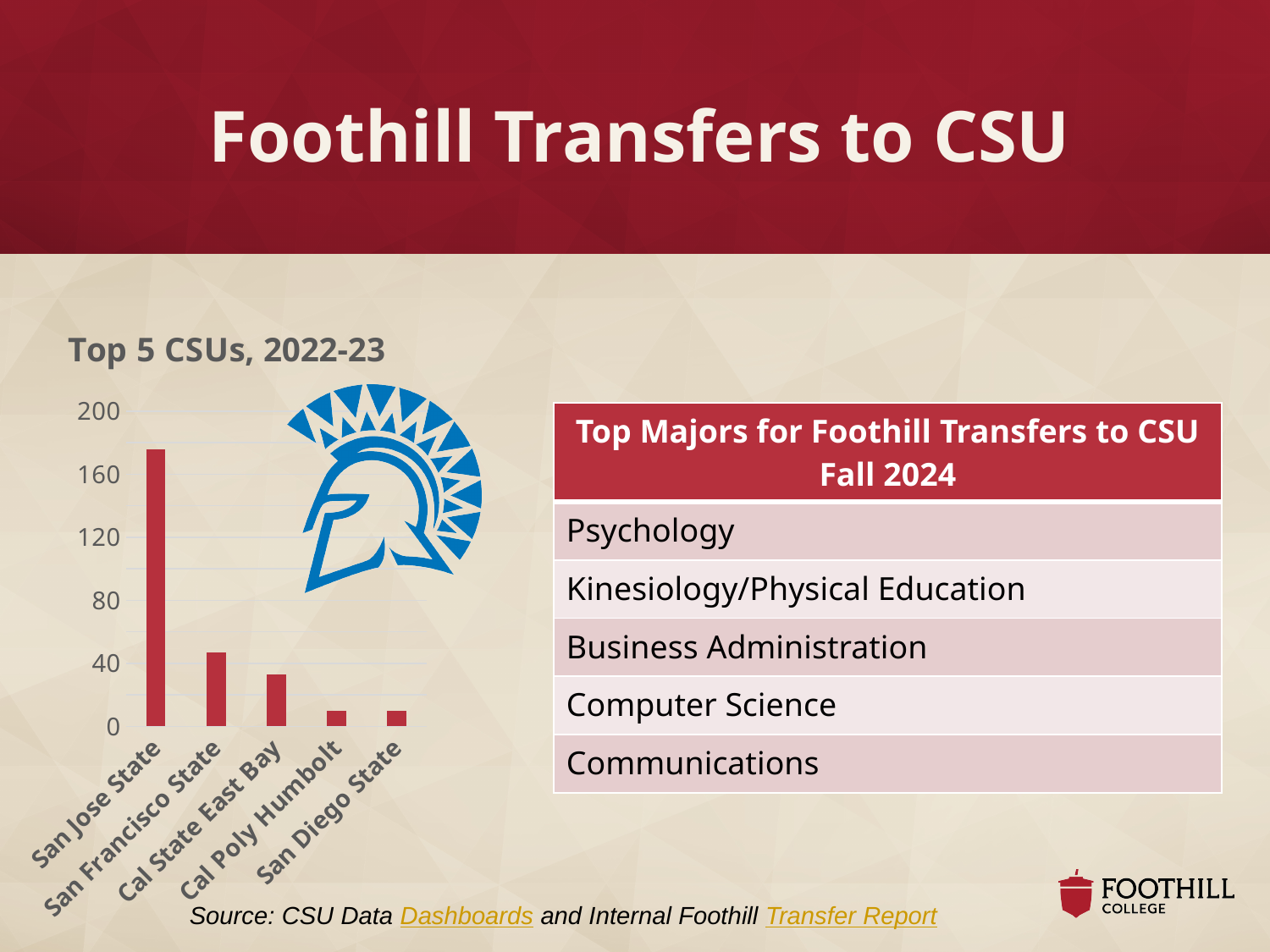
Is the value for Cal State East Bay greater or less than 40? less What is the title of the chart on the slide? Top 5 CSUs, 2022-23 What kind of chart is shown on the slide? bar chart Is the value for Cal Poly Humbolt greater or less than 40? less Which has a larger value, San Jose State or San Francisco State? San Jose State Is the value for San Francisco State greater or less than 40? greater Do the bar values rise or fall from left to right across the chart? fall How many CSU campuses are shown in the chart? 5 Which has a larger value, San Francisco State or Cal State East Bay? San Francisco State Which CSU campus has the highest bar in the chart? San Jose State